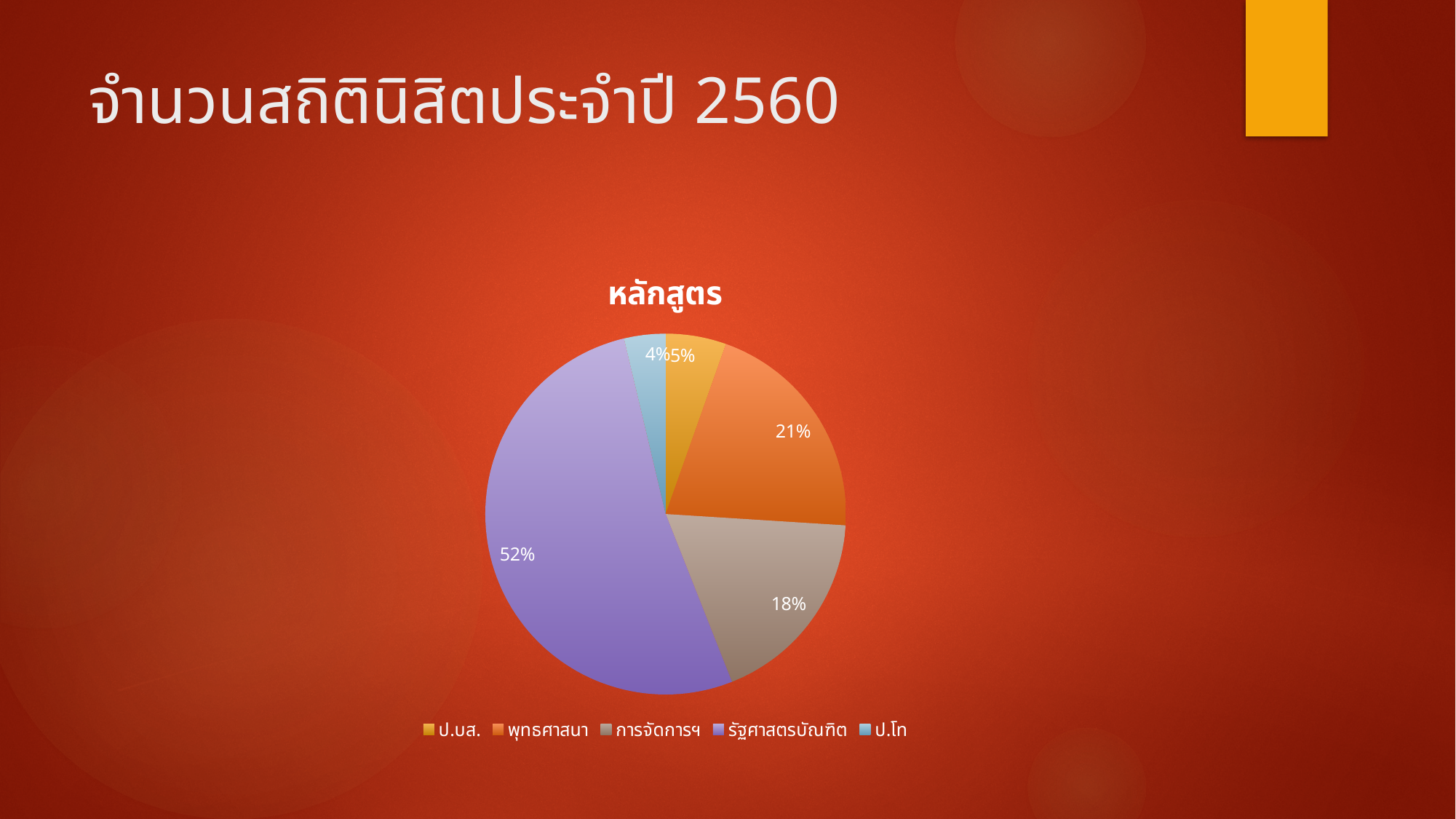
How many slices does the pie chart have? 5 What share of the pie does ป.โท have? 4% What share of the pie does ป.บส. have? 5% What is the difference in percentage points between พุทธศาสนา and การจัดการฯ? 3% What kind of chart is shown on the slide? pie chart What share of the pie does พุทธศาสนา have? 21% Which category has the smallest slice of the pie? ป.โท How many entries does the legend list? 5 What is the title of the chart? หลักสูตร Which category has the largest slice of the pie? รัฐศาสตรบัณฑิต